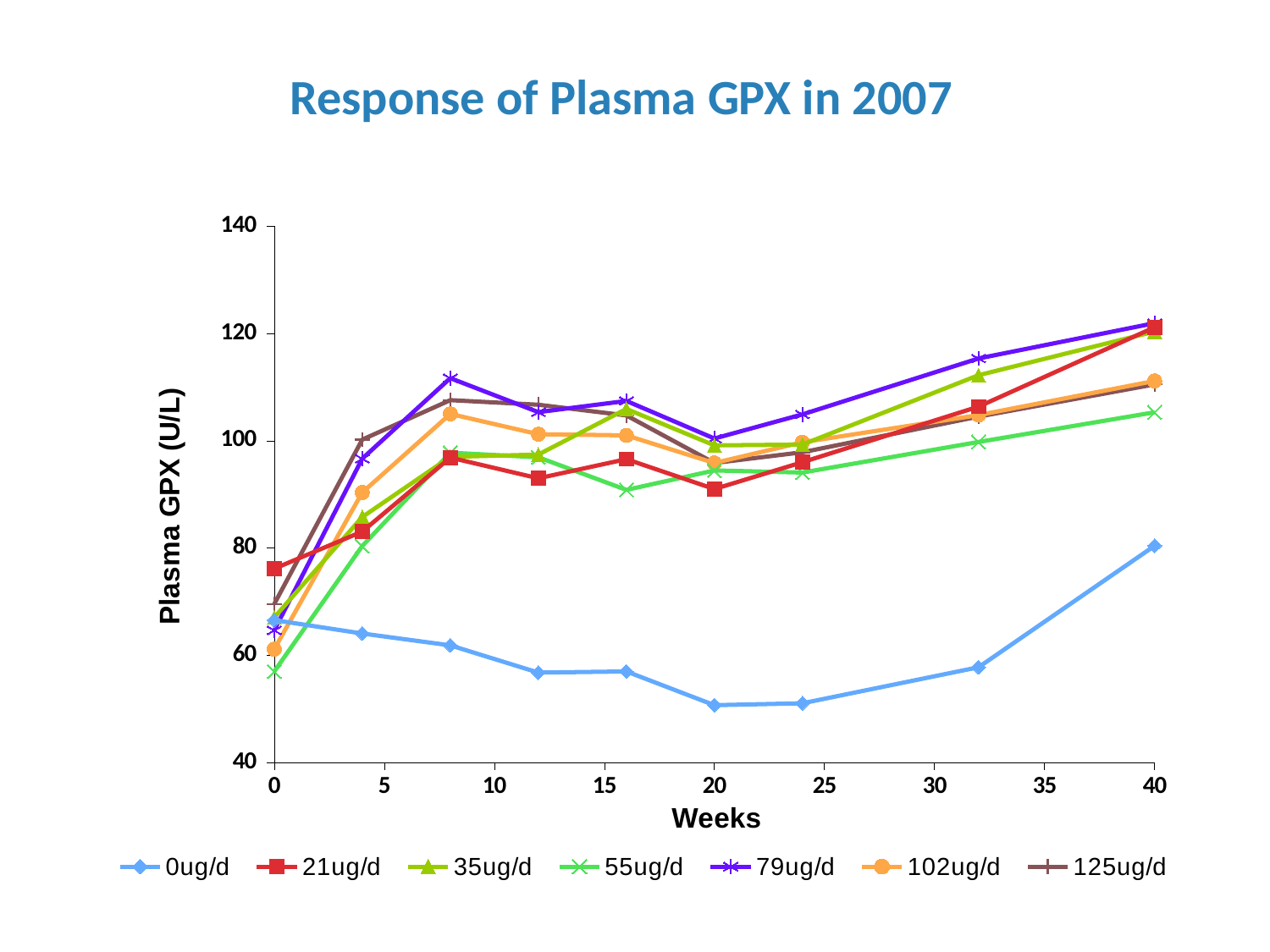
What is the title of the chart? Response of Plasma GPX in 2007 Which series has the lowest value at week 40? 0ug/d What is the label on the vertical axis? Plasma GPX (U/L) Does the 0ug/d series rise or fall from week 0 to week 20? fall Is the value for 0ug/d at week 40 greater or less than 100? less At week 0, which is larger: the value for 21ug/d or the value for 55ug/d? 21ug/d Which series has the highest value at week 8? 79ug/d How many series does the legend list? 7 What kind of chart is shown on the slide? line chart Is the value for 0ug/d at week 20 greater or less than 60? less Is the value for 79ug/d at week 40 greater or less than 110? greater